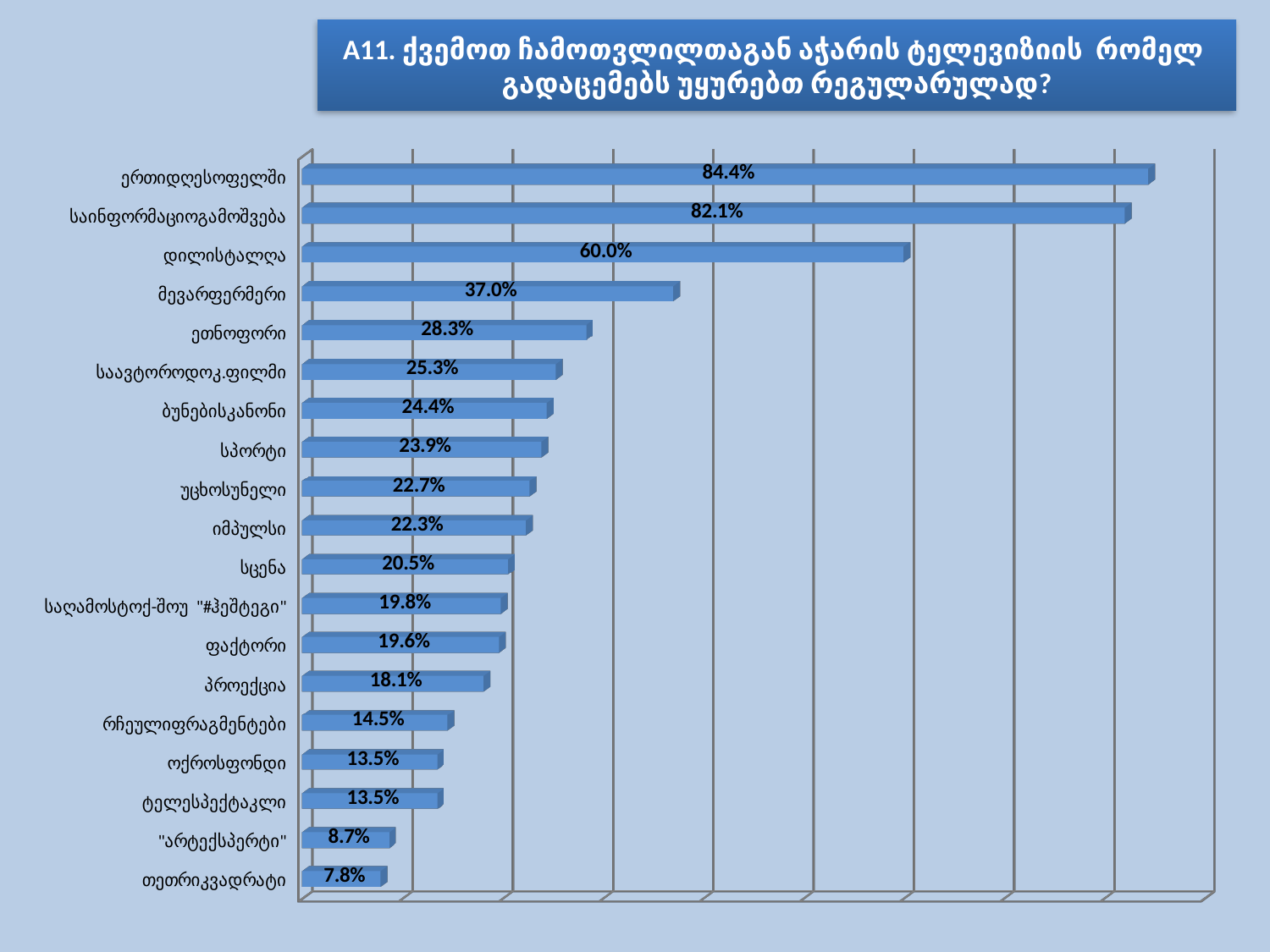
What is the difference between the values for დილისტალღა and მევარფერმერი? 23.0% What is the value for თეთრიკვადრატი? 7.8% What is the value for ოქროსფონდი? 13.5% Which category has the lowest value? თეთრიკვადრატი What is the difference between the values for ერთიდღესოფელში and საინფორმაციოგამოშვება? 2.3% How many categories are shown in the chart? 19 What is the value for სპორტი? 23.9% Which is larger, the value for ეთნოფორი or the value for პროექცია? ეთნოფორი What is the value for ერთიდღესოფელში? 84.4% What kind of chart is shown on the slide? bar chart Which category has the highest value? ერთიდღესოფელში What is the value for დილისტალღა? 60.0%